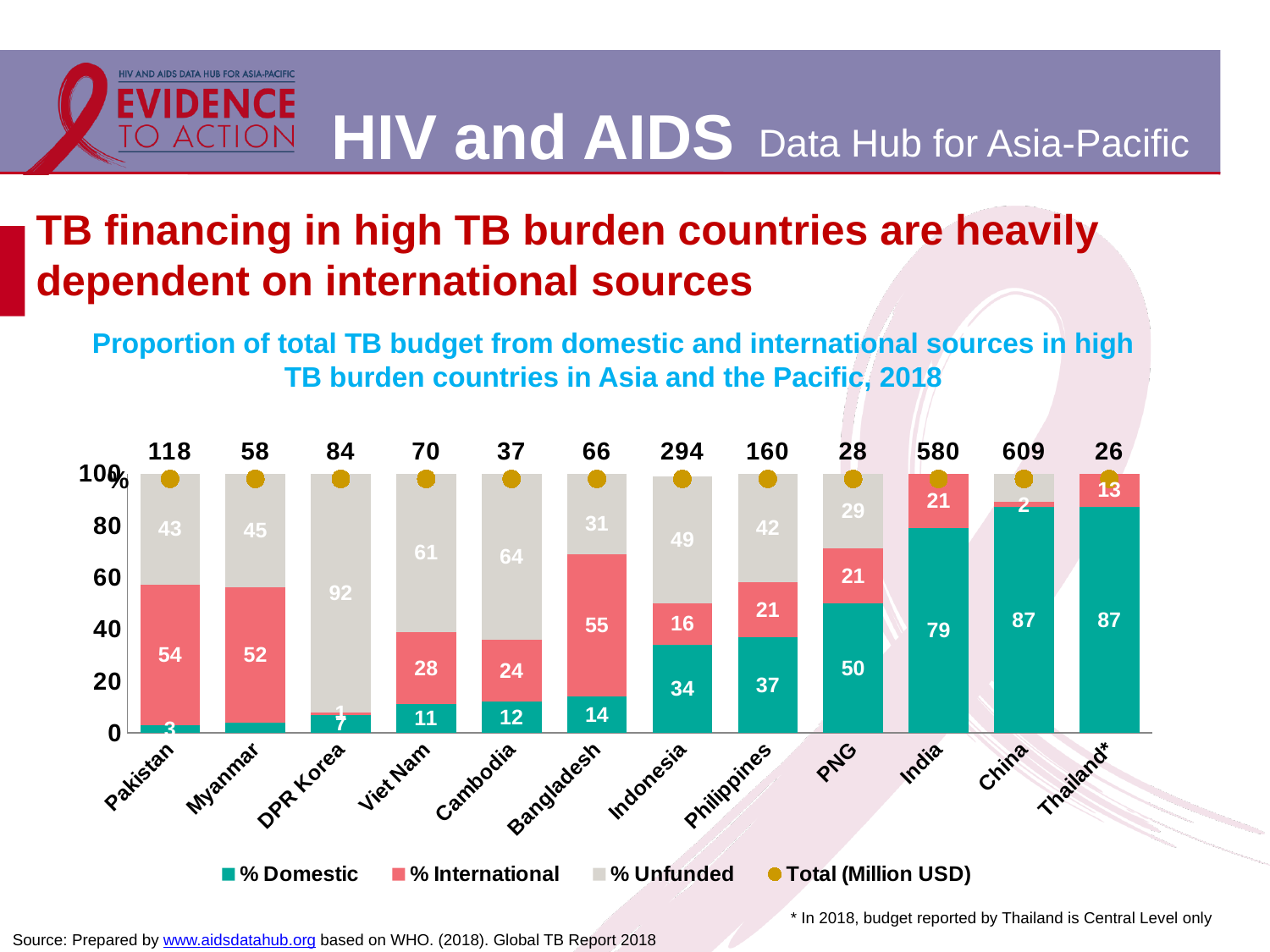
What is the Total (Million USD) value shown for India? 580 Which country has the lowest Total (Million USD)? Thailand What is the difference between the % Domestic values for China and Pakistan? 84 What is the % International value for Bangladesh? 55 What is the % Unfunded value for DPR Korea? 92 What kind of chart is shown on the slide? Stacked bar chart How many series does the legend list? 4 Which country has the highest Total (Million USD)? China How many countries are shown on the x axis of the chart? 12 Which country has the highest % Unfunded value? DPR Korea What is the % Domestic value for Indonesia? 34 Which has a larger % International value, Pakistan or Myanmar? Pakistan